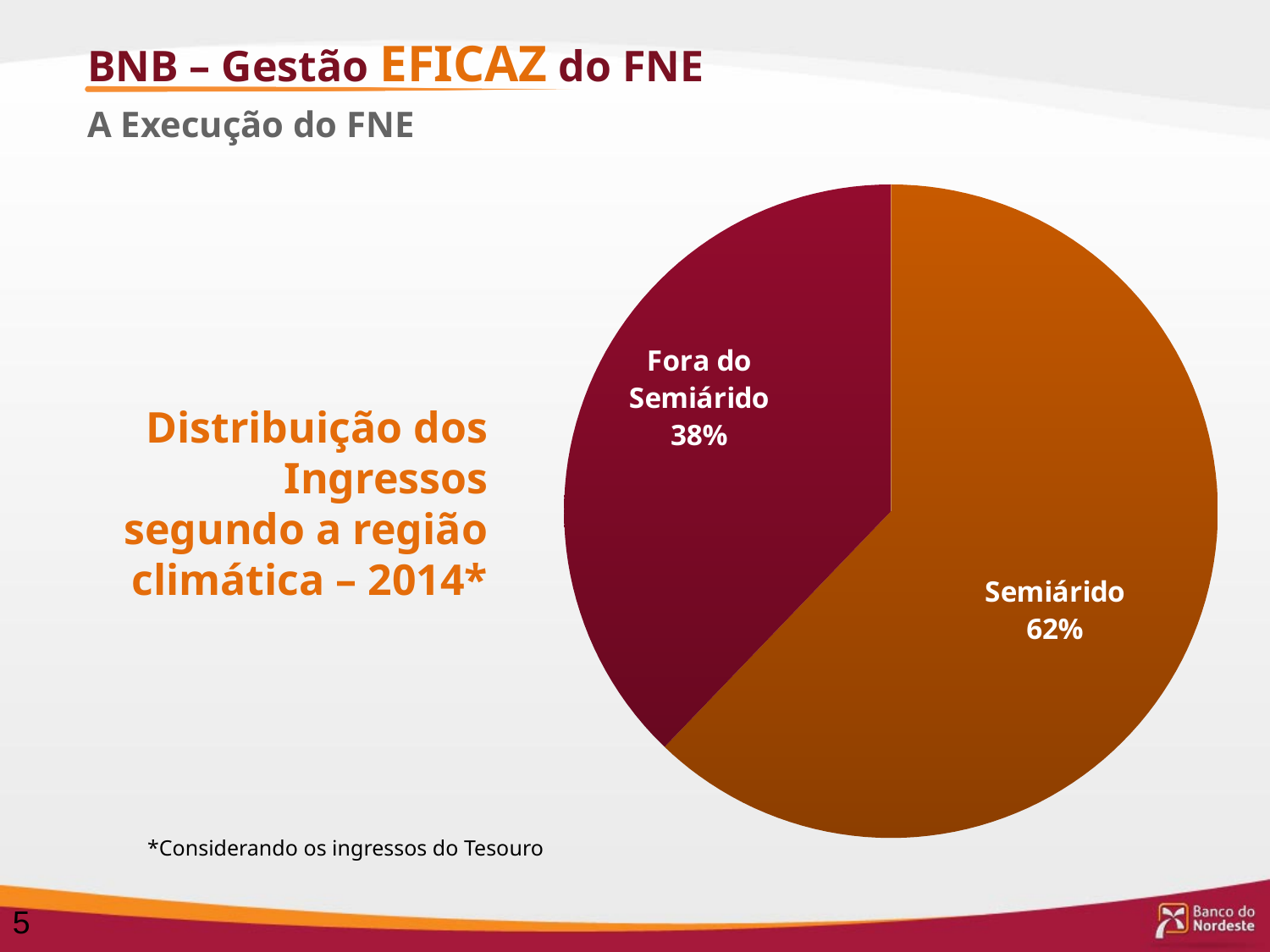
What colour is the Semiárido slice? orange What share of the pie does Fora do Semiárido represent? 38% Which slice of the pie is the largest? Semiárido Which is larger, the Semiárido slice or the Fora do Semiárido slice? Semiárido What is the title of the chart? Distribuição dos Ingressos segundo a região climática – 2014* What share of the pie does Semiárido represent? 62% What type of chart is shown on the slide? pie chart Which slice of the pie is the smallest? Fora do Semiárido What is the difference in percentage points between the Semiárido and Fora do Semiárido slices? 24 How many slices does the pie chart have? 2